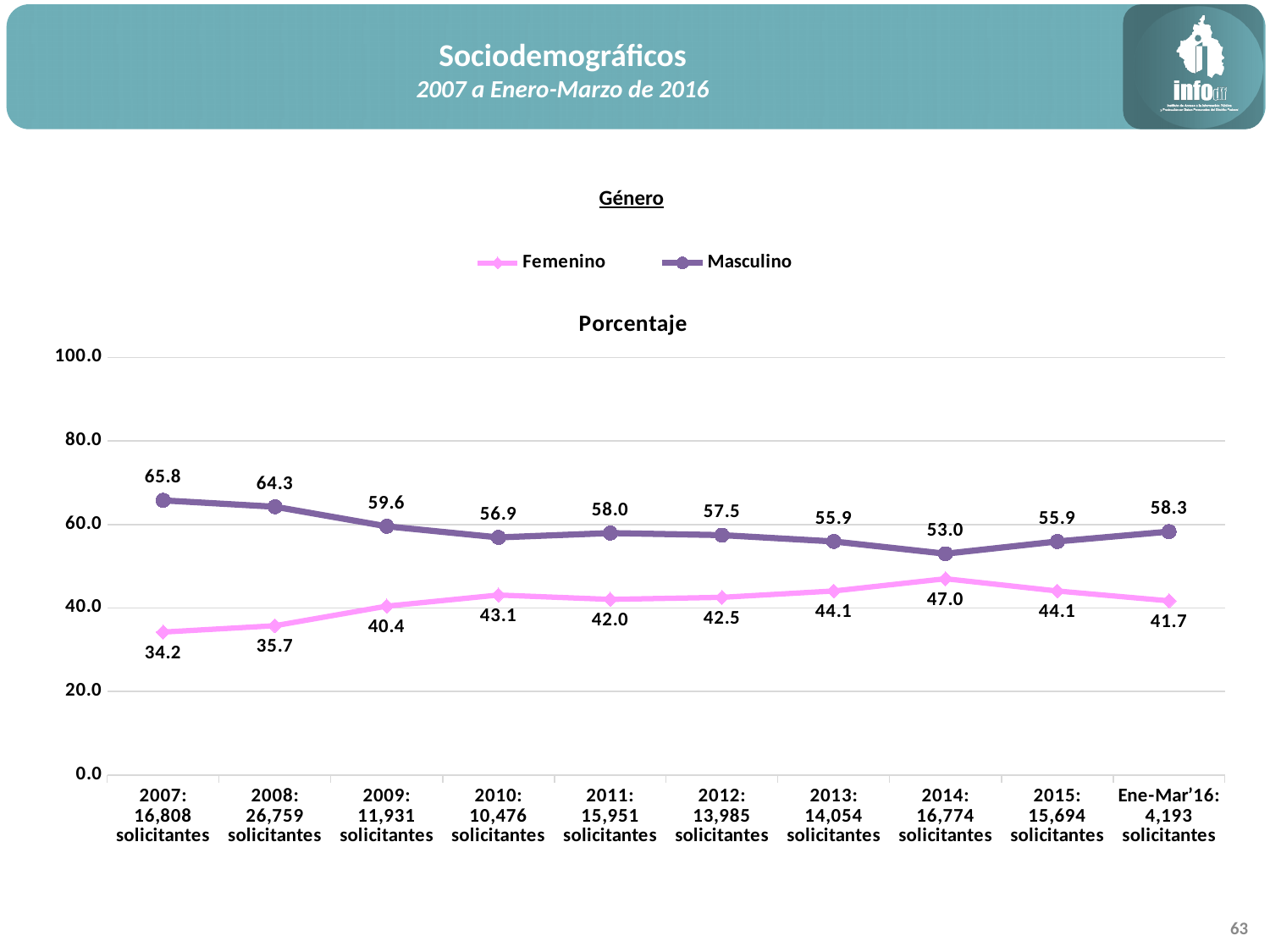
What is the Masculino value for 2007? 65.8 What kind of chart is shown on the slide? Line chart How many series does the legend list? 2 In which year does the Femenino series reach its highest value? 2014 What is the Femenino value for Ene-Mar'16? 41.7 Which is larger in 2011, the Femenino value or the Masculino value? Masculino What is the difference between the Masculino and Femenino values in 2007? 31.6 In which year does the Masculino series reach its lowest value? 2014 What is the difference between the Masculino and Femenino values in 2014? 6.0 How many time periods are shown on the x axis? 10 Does the Masculino series rise or fall from 2007 to 2010? Fall What is the Femenino value for 2014? 47.0